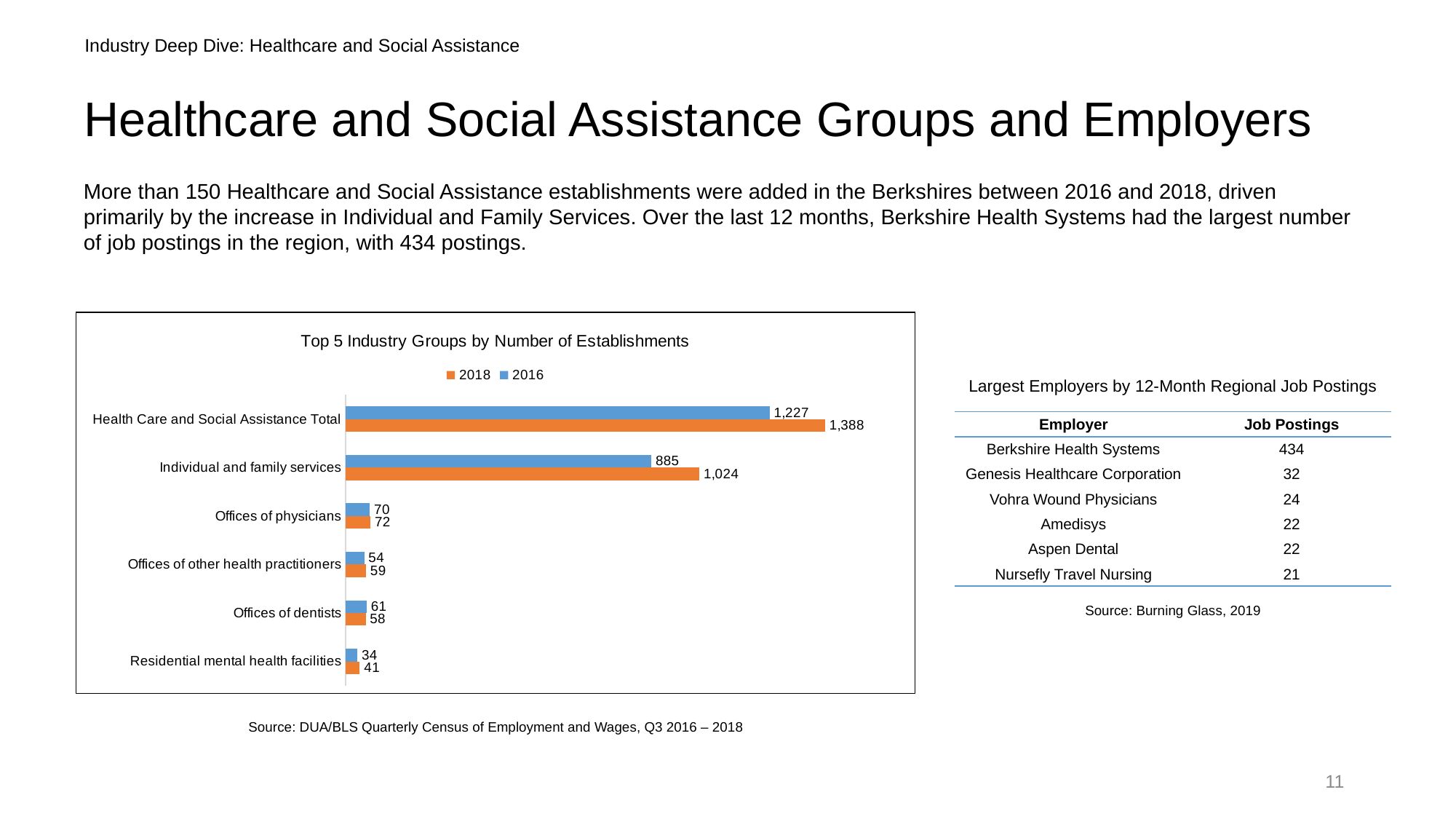
What is the 2018 value for Individual and family services in the Top 5 Industry Groups chart? 1,024 For Offices of other health practitioners, which year has the larger value, 2016 or 2018? 2018 What is the difference between the 2018 and 2016 values for Individual and family services? 139 Which category has the lowest 2016 value in the Top 5 Industry Groups chart? Residential mental health facilities What is the 2018 value for Residential mental health facilities in the Top 5 Industry Groups chart? 41 How many series does the legend of the Top 5 Industry Groups chart list? 2 For Offices of dentists, which year has the larger value, 2016 or 2018? 2016 Excluding the total, which industry group has the highest 2018 value in the Top 5 Industry Groups chart? Individual and family services What is the difference between the 2018 and 2016 values for Health Care and Social Assistance Total? 161 What is the 2016 value for Offices of dentists in the Top 5 Industry Groups chart? 61 How many categories are shown in the Top 5 Industry Groups chart? 6 What type of chart is the Top 5 Industry Groups by Number of Establishments chart? Bar chart